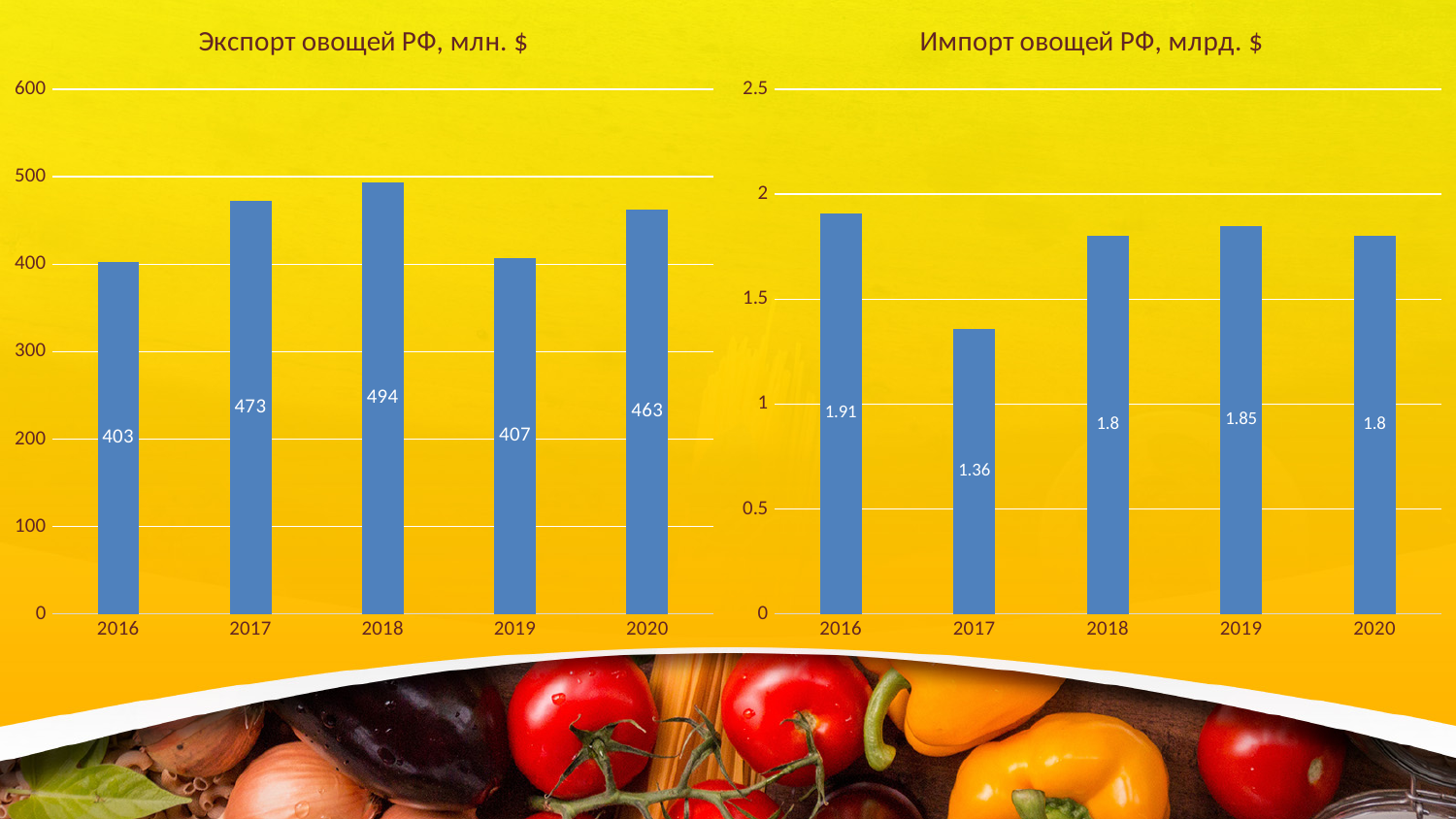
In the chart titled 'Импорт овощей РФ, млрд. $', what is the value for 2017? 1.36 In the chart titled 'Экспорт овощей РФ, млн. $', what is the value for 2018? 494 What is the title of the chart on the left side of the slide? Экспорт овощей РФ, млн. $ In the chart titled 'Импорт овощей РФ, млрд. $', what is the difference between the values for 2016 and 2017? 0.55 In the chart titled 'Импорт овощей РФ, млрд. $', which year has the highest value? 2016 In the chart titled 'Экспорт овощей РФ, млн. $', how many years are shown on the x axis? 5 What kind of chart is the chart titled 'Импорт овощей РФ, млрд. $'? bar chart In the chart titled 'Экспорт овощей РФ, млн. $', what is the difference between the values for 2018 and 2016? 91 In the chart titled 'Экспорт овощей РФ, млн. $', which is larger, the value for 2017 or the value for 2020? 2017 In the chart titled 'Импорт овощей РФ, млрд. $', is the value for 2019 greater or less than 1.5? greater In the chart titled 'Импорт овощей РФ, млрд. $', what is the value for 2019? 1.85 In the chart titled 'Экспорт овощей РФ, млн. $', which year has the lowest value? 2016